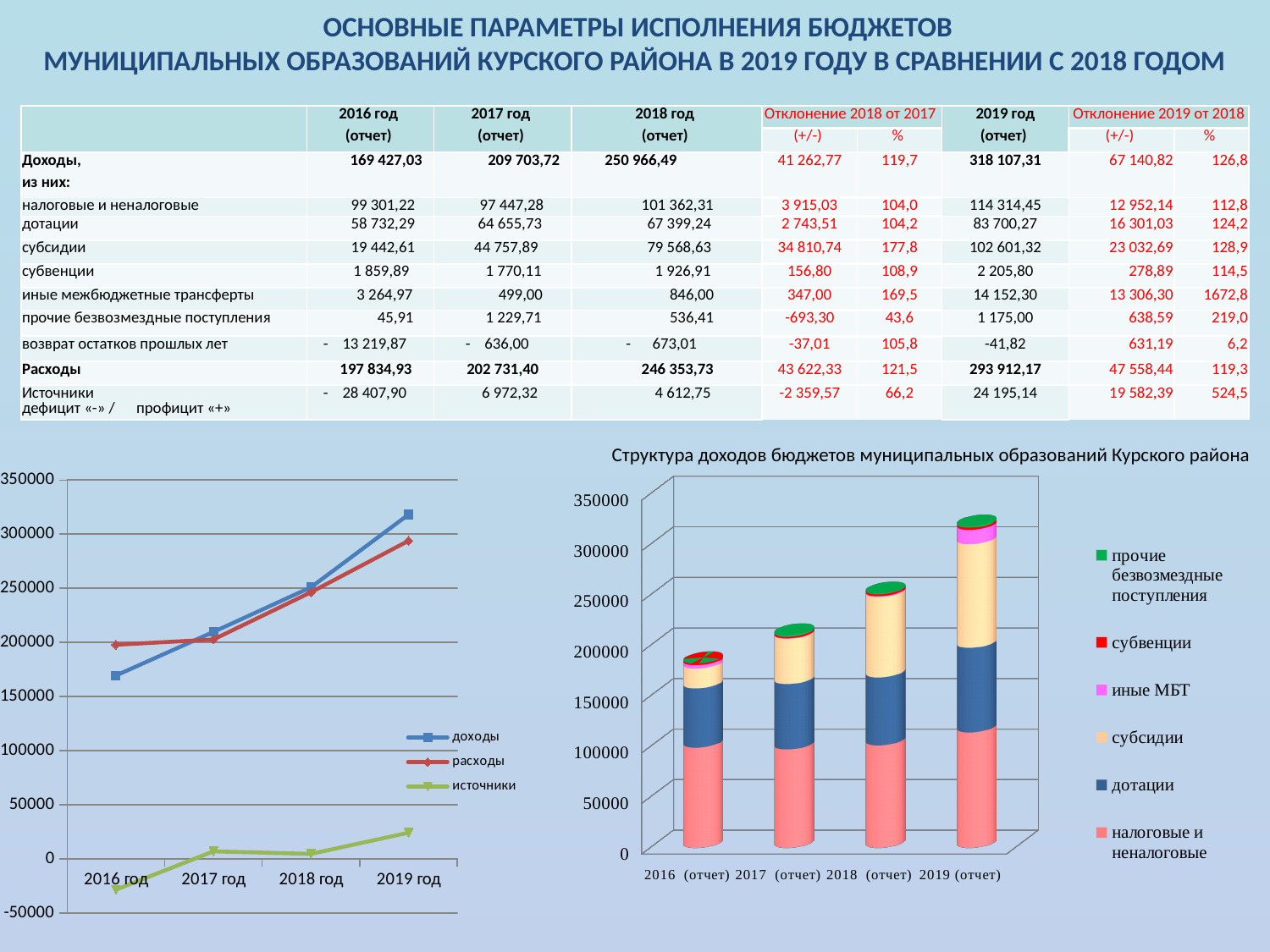
In the left line chart, which is larger in 2019 год: доходы or расходы? доходы In the chart 'Структура доходов бюджетов муниципальных образований Курского района', which year has the tallest bar? 2019 (отчет) How many years are plotted along the x axis of the left line chart? 4 What kind of chart is the chart on the left of the slide? line chart In the left line chart, is the value for доходы in 2019 год greater or less than 300000? greater How many series does the legend of the chart 'Структура доходов бюджетов муниципальных образований Курского района' list? 6 In the left line chart, which series has the lowest values across all years? источники In the left line chart, do the values for доходы rise or fall from 2016 год to 2019 год? rise What kind of chart is the chart titled 'Структура доходов бюджетов муниципальных образований Курского района'? stacked bar chart In the left line chart, is the value for источники in 2016 год greater or less than 0? less In the chart 'Структура доходов бюджетов муниципальных образований Курского района', which series forms the largest segment of the 2016 (отчет) bar? налоговые и неналоговые How many series does the legend of the left line chart list? 3